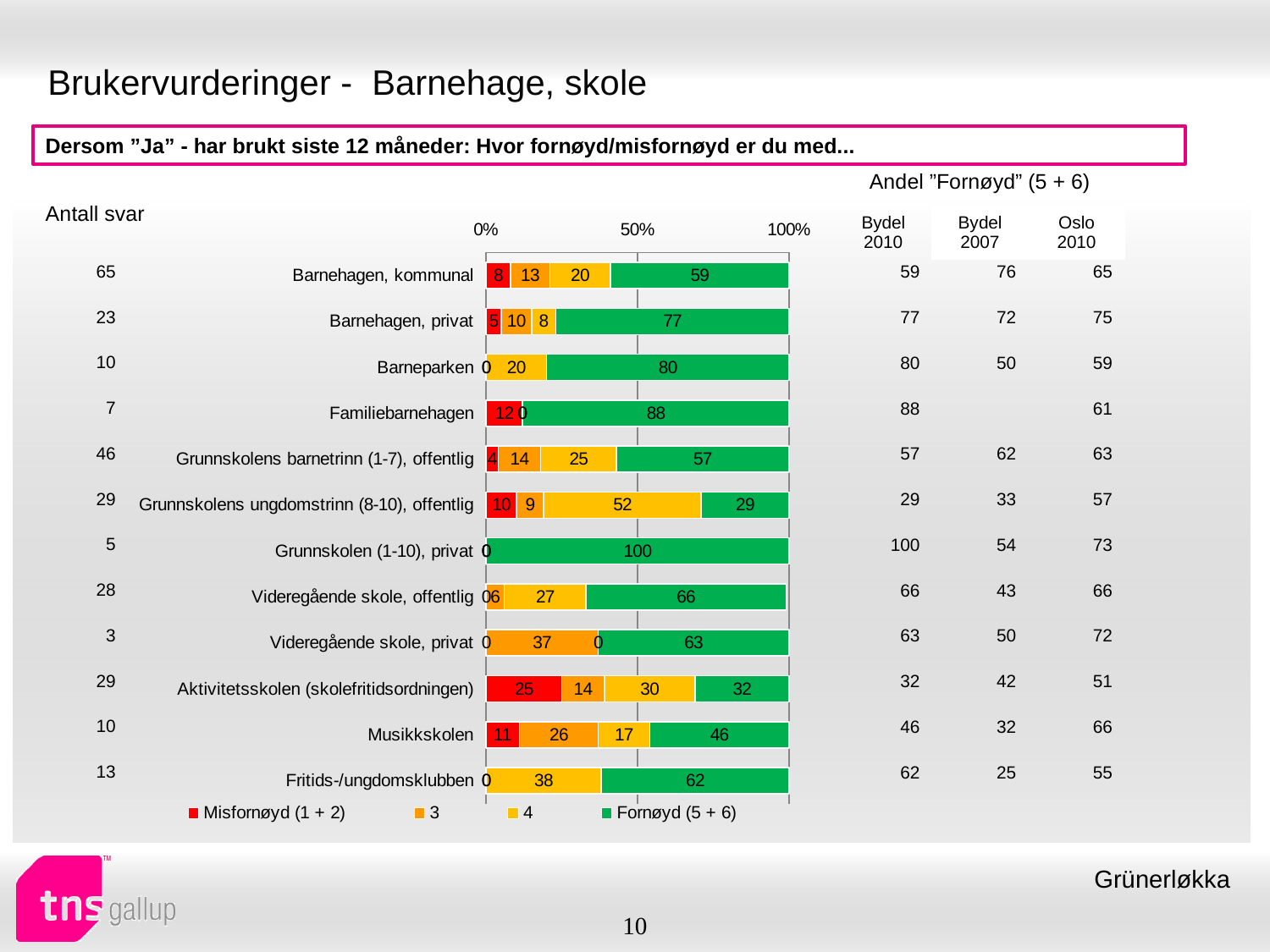
What is the first entry in the chart legend? Misfornøyd (1 + 2) How many series does the legend list? 4 Which category has the lowest Fornøyd (5 + 6) value? Grunnskolens ungdomstrinn (8-10), offentlig Which category has the highest Fornøyd (5 + 6) value? Grunnskolen (1-10), privat What is the Fornøyd (5 + 6) value for Barnehagen, kommunal? 59 What is the difference between the Fornøyd (5 + 6) values for Barnehagen, privat and Barnehagen, kommunal? 18 Which has the larger Misfornøyd (1 + 2) value, Aktivitetsskolen (skolefritidsordningen) or Musikkskolen? Aktivitetsskolen (skolefritidsordningen) What kind of chart is shown on the slide? Stacked bar chart What is the Misfornøyd (1 + 2) value for Familiebarnehagen? 12 How many categories are shown in the chart? 12 What is the value of the '4' segment for Grunnskolens ungdomstrinn (8-10), offentlig? 52 What is the value of the '3' segment for Musikkskolen? 26